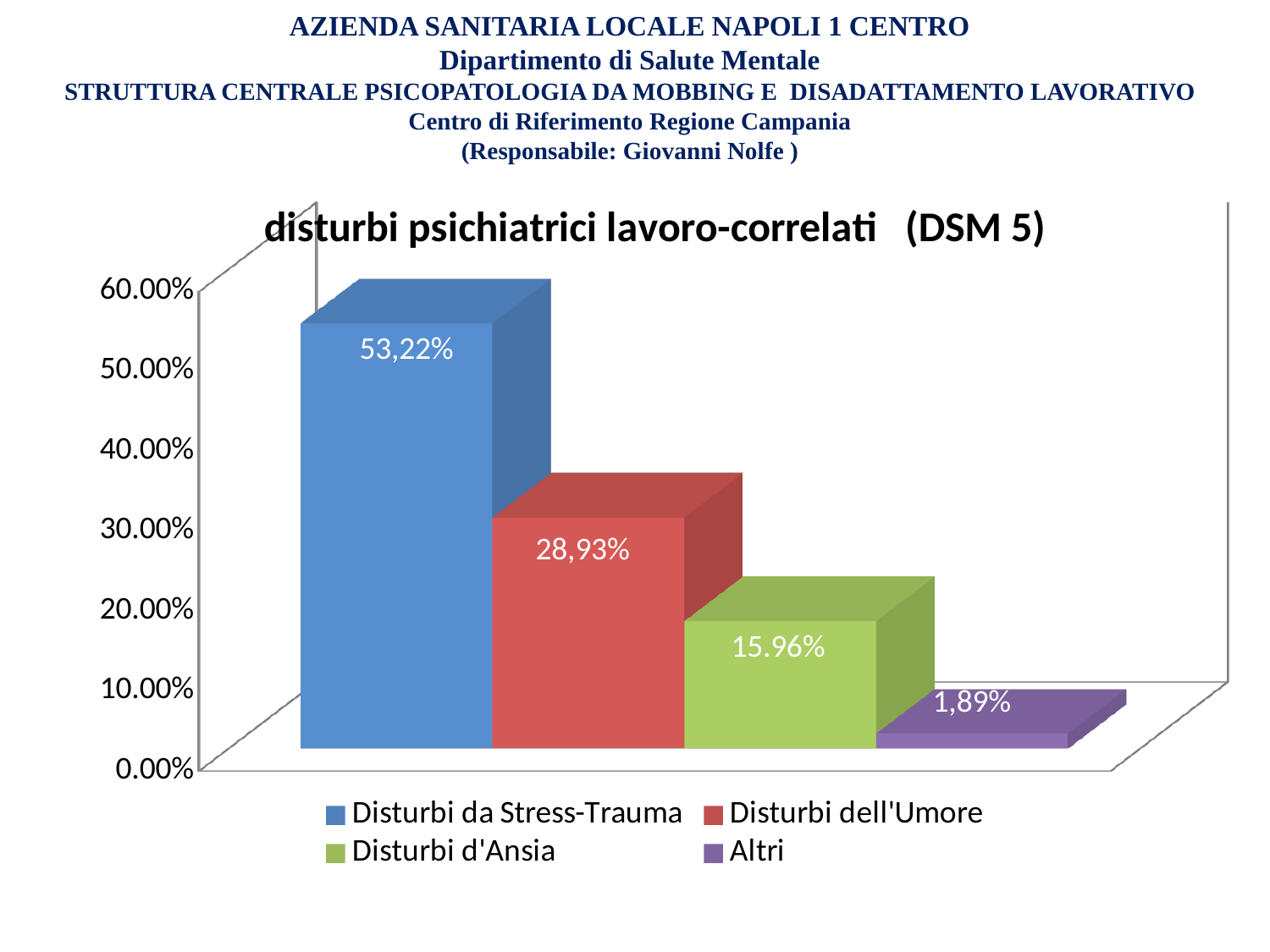
What value is shown for Disturbi dell'Umore? 28,93% What value is shown for Disturbi da Stress-Trauma? 53,22% What value is shown for Altri? 1,89% Which is larger, the value for Disturbi dell'Umore or the value for Disturbi d'Ansia? Disturbi dell'Umore How many bars are plotted in the chart? 4 Which category has the highest value? Disturbi da Stress-Trauma How many entries does the legend list? 4 Which category has the lowest value? Altri What is the difference between the values for Disturbi da Stress-Trauma and Disturbi dell'Umore? 24,29% What is the title of the chart? disturbi psichiatrici lavoro-correlati (DSM 5) Is the value for Disturbi da Stress-Trauma greater or less than 50.00%? greater What value is shown for Disturbi d'Ansia? 15.96%